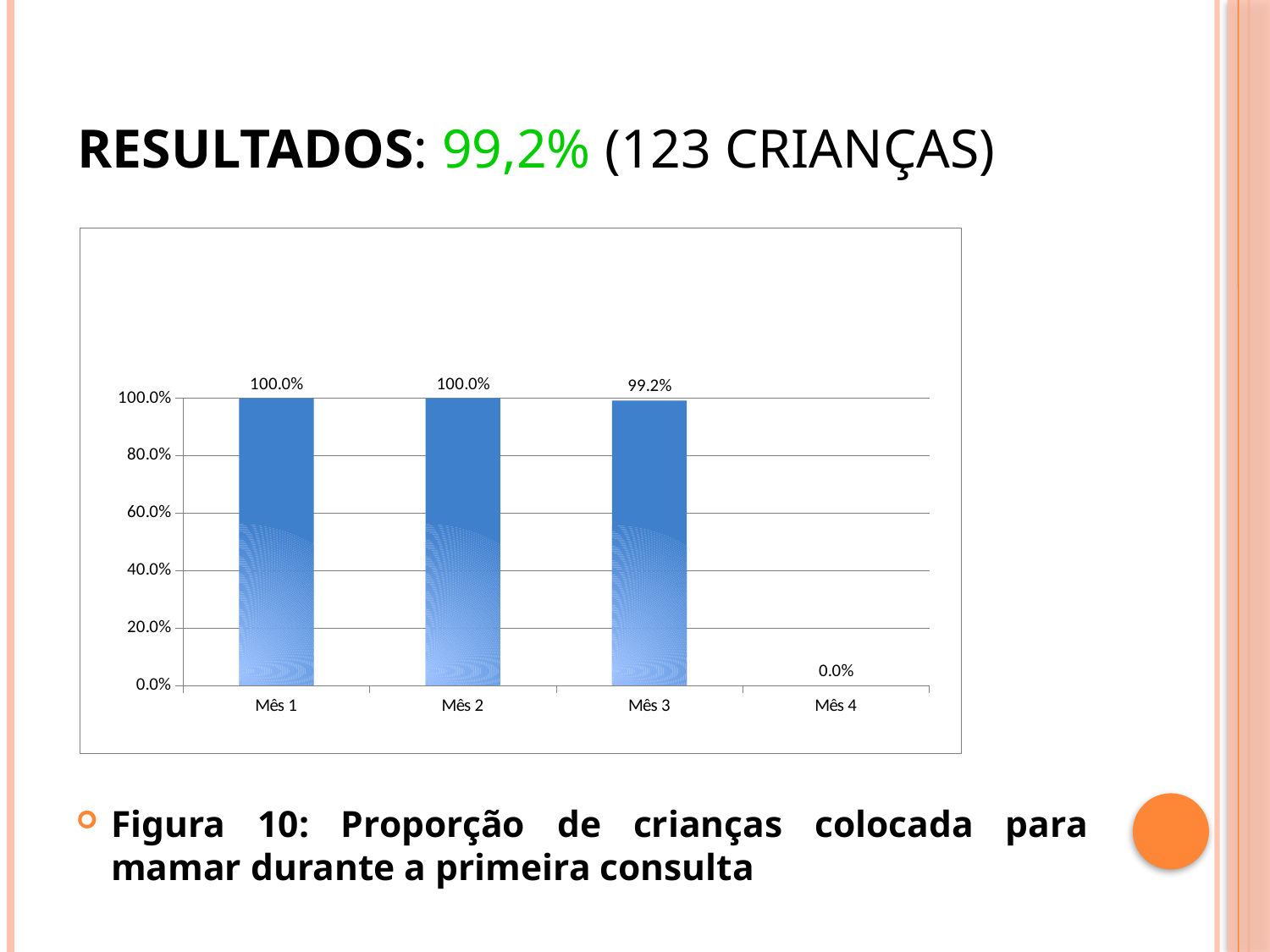
Which is larger, the value for Mês 2 or the value for Mês 3? Mês 2 How many categories are shown on the x axis? 4 What is the value for Mês 4? 0.0% Is the value for Mês 3 greater or less than 80.0%? greater What is the difference between the values for Mês 1 and Mês 3? 0.8% What is the value for Mês 1? 100.0% What is the highest value shown on the y axis? 100.0% Do the values rise or fall from Mês 3 to Mês 4? fall Which category has the lowest value? Mês 4 What is the difference between the values for Mês 3 and Mês 4? 99.2% What is the value for Mês 3? 99.2% What kind of chart is shown on the slide? bar chart